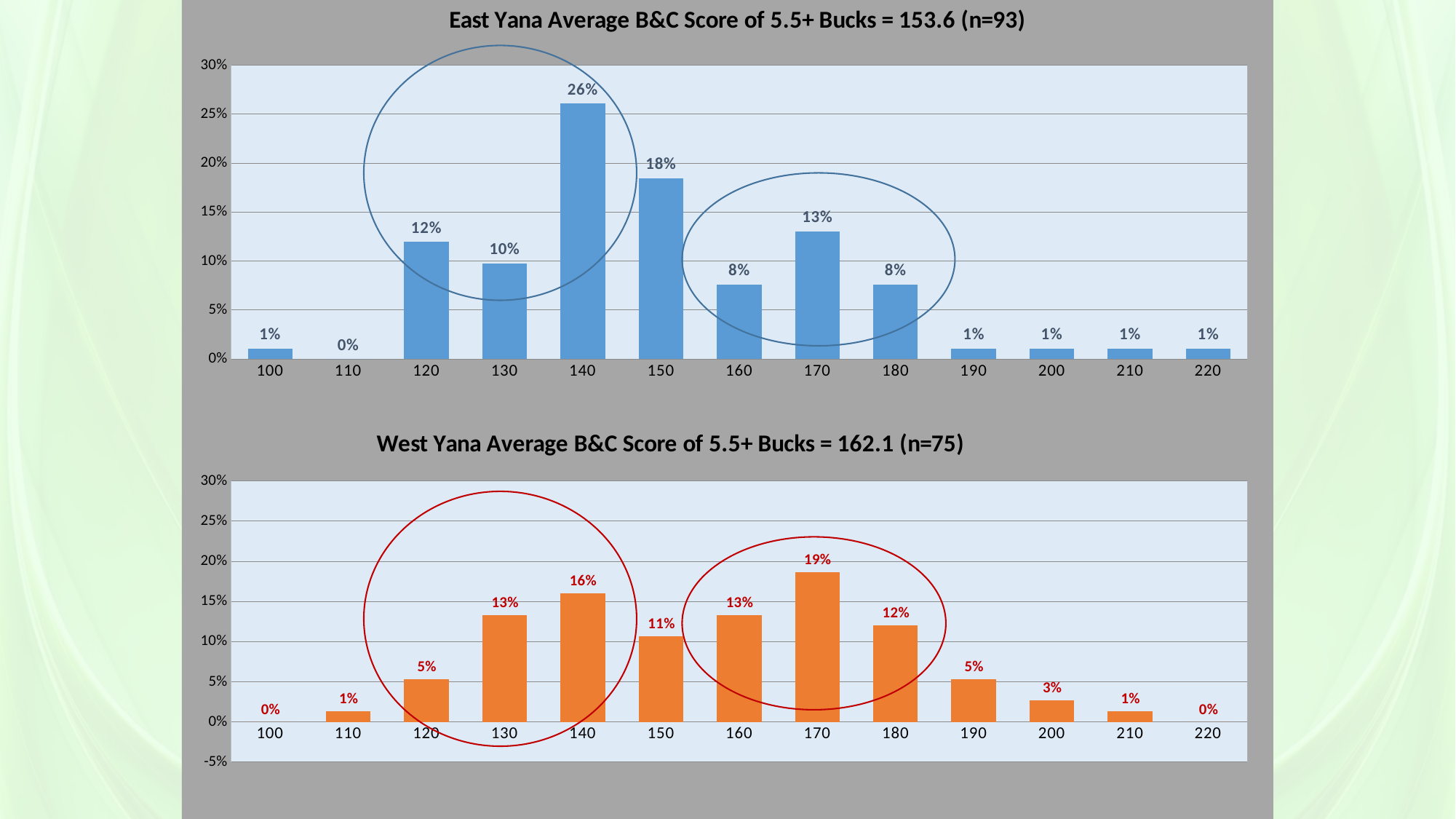
What colour are the bars in the East Yana chart? Blue In the West Yana chart, what is the value for 170? 19% In the West Yana chart, which is larger, the value for 130 or the value for 150? 130 What is the title of the bottom chart? West Yana Average B&C Score of 5.5+ Bucks = 162.1 (n=75) In the East Yana chart, what is the difference between the values for 140 and 150? 8% In the West Yana chart, which score category has the highest value? 170 How many score categories are shown on the x axis of the West Yana chart? 13 In the East Yana chart, is the value for 150 greater or less than 15%? greater In the East Yana chart, what is the value for 140? 26% In the East Yana chart, which score category has the highest value? 140 What kind of chart is the East Yana chart? Bar chart In the West Yana chart, do the values rise or fall from 170 to 220? Fall